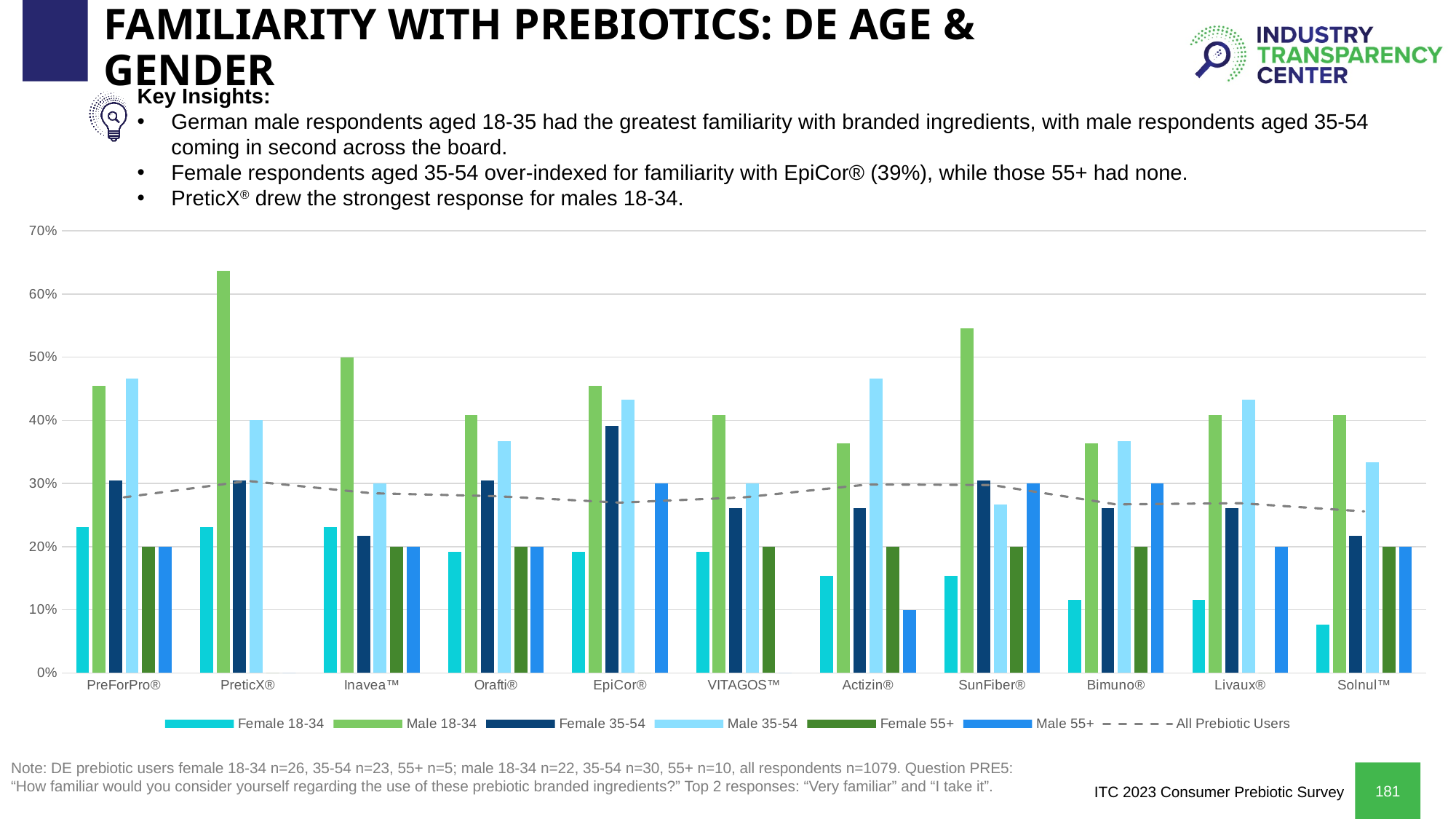
How many branded ingredients are shown on the x axis of the chart? 11 Is the Male 35-54 value for Actizin® greater or less than 40%? greater For PreticX®, which is larger: the Male 18-34 bar or the Male 35-54 bar? Male 18-34 Which series is drawn as a dashed line in the chart? All Prebiotic Users Is the Male 18-34 value for SunFiber® greater or less than 50%? greater Which branded ingredient has the highest Male 18-34 bar? PreticX® Do the Female 18-34 values generally rise or fall moving from PreForPro® to Solnul™ along the x axis? fall How many series does the chart legend list? 7 Is the Male 18-34 value for PreticX® greater or less than 60%? greater What kind of chart is shown on the slide? combination bar and line chart Which branded ingredient has the lowest Female 18-34 bar? Solnul™